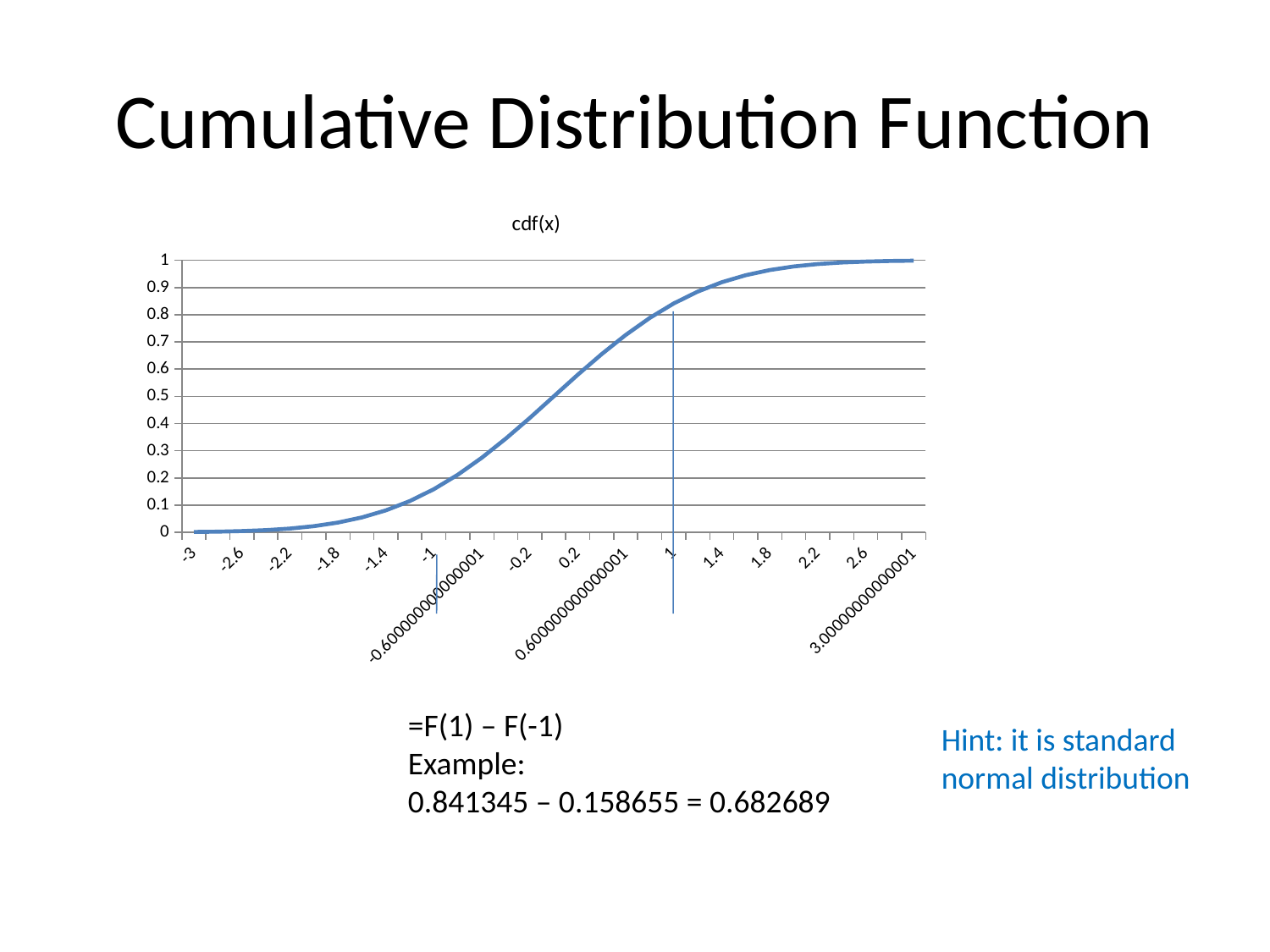
Is the value of cdf(x) at x = -1.4 greater or less than 0.2? less What is the highest value shown on the y axis? 1 Which is larger, the value of cdf(x) at x = 1 or at x = -1? x = 1 Is the value of cdf(x) at x = -2.2 greater or less than 0.1? less What kind of chart is shown on the slide? line chart What is the title of the chart? cdf(x) Is the value of cdf(x) at x = 1 greater or less than 0.8? greater Do the plotted values rise or fall as x increases along the x axis? rise